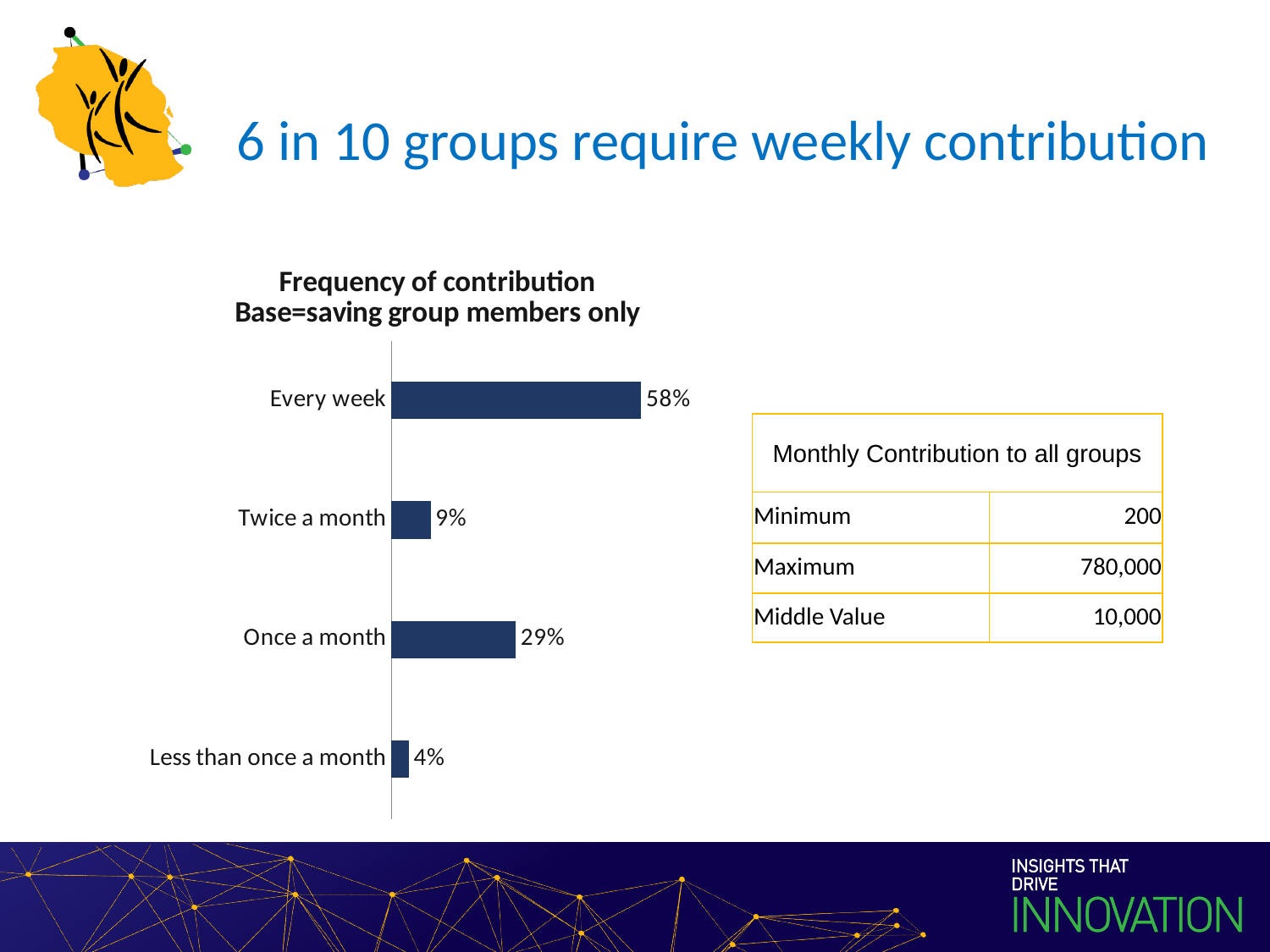
What is the difference in percentage points between 'Every week' and 'Once a month'? 29 What percentage of saving group members contribute every week? 58% What is the value for 'Less than once a month'? 4% What type of chart is used to show frequency of contribution? Bar chart What is the title of the chart? Frequency of contribution Base=saving group members only What is the value for 'Twice a month'? 9% Which contribution frequency has the highest share? Every week What is the difference in percentage points between 'Twice a month' and 'Less than once a month'? 5 Which is larger, the share for 'Once a month' or 'Twice a month'? Once a month Which contribution frequency has the lowest share? Less than once a month How many contribution frequency categories are shown in the chart? 4 What is the value for 'Once a month' in the Frequency of contribution chart? 29%